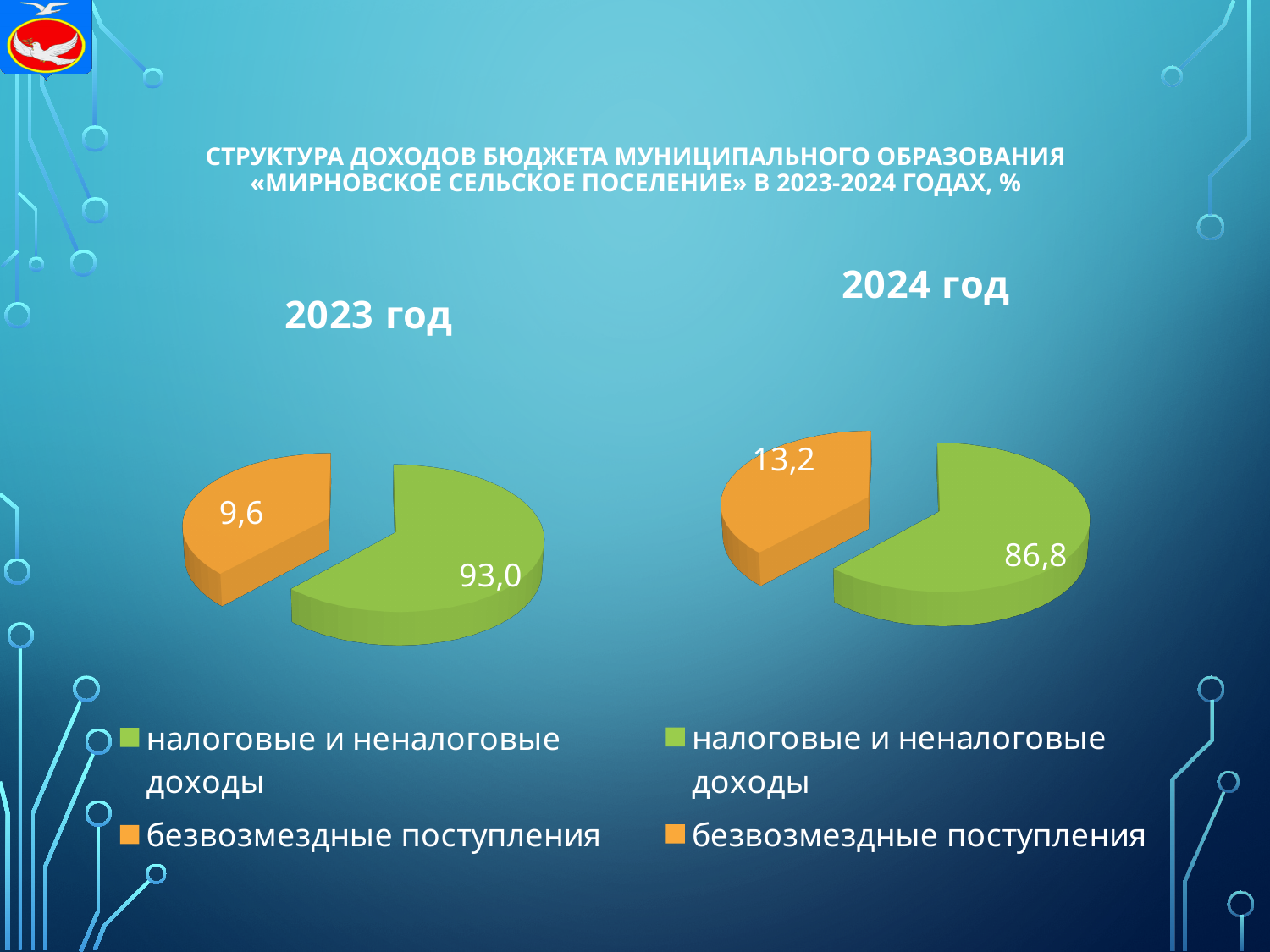
In the "2024 год" chart, what is the value for налоговые и неналоговые доходы? 86,8 Which is larger: налоговые и неналоговые доходы in the "2023 год" chart or in the "2024 год" chart? 2023 год How many slices does the "2024 год" chart have? 2 What kind of chart is the "2023 год" chart? pie chart How many entries does the legend of the "2023 год" chart list? 2 In the "2023 год" chart, what is the value for налоговые и неналоговые доходы? 93,0 In the "2024 год" chart, what is the value for безвозмездные поступления? 13,2 In the "2024 год" chart, which category has the largest slice? налоговые и неналоговые доходы In the "2023 год" chart, what is the value for безвозмездные поступления? 9,6 What is the difference between the value for безвозмездные поступления in the "2024 год" chart and in the "2023 год" chart? 3,6 In the "2023 год" chart, which category has the smallest slice? безвозмездные поступления In the "2024 год" chart, what colour is the slice for безвозмездные поступления? orange